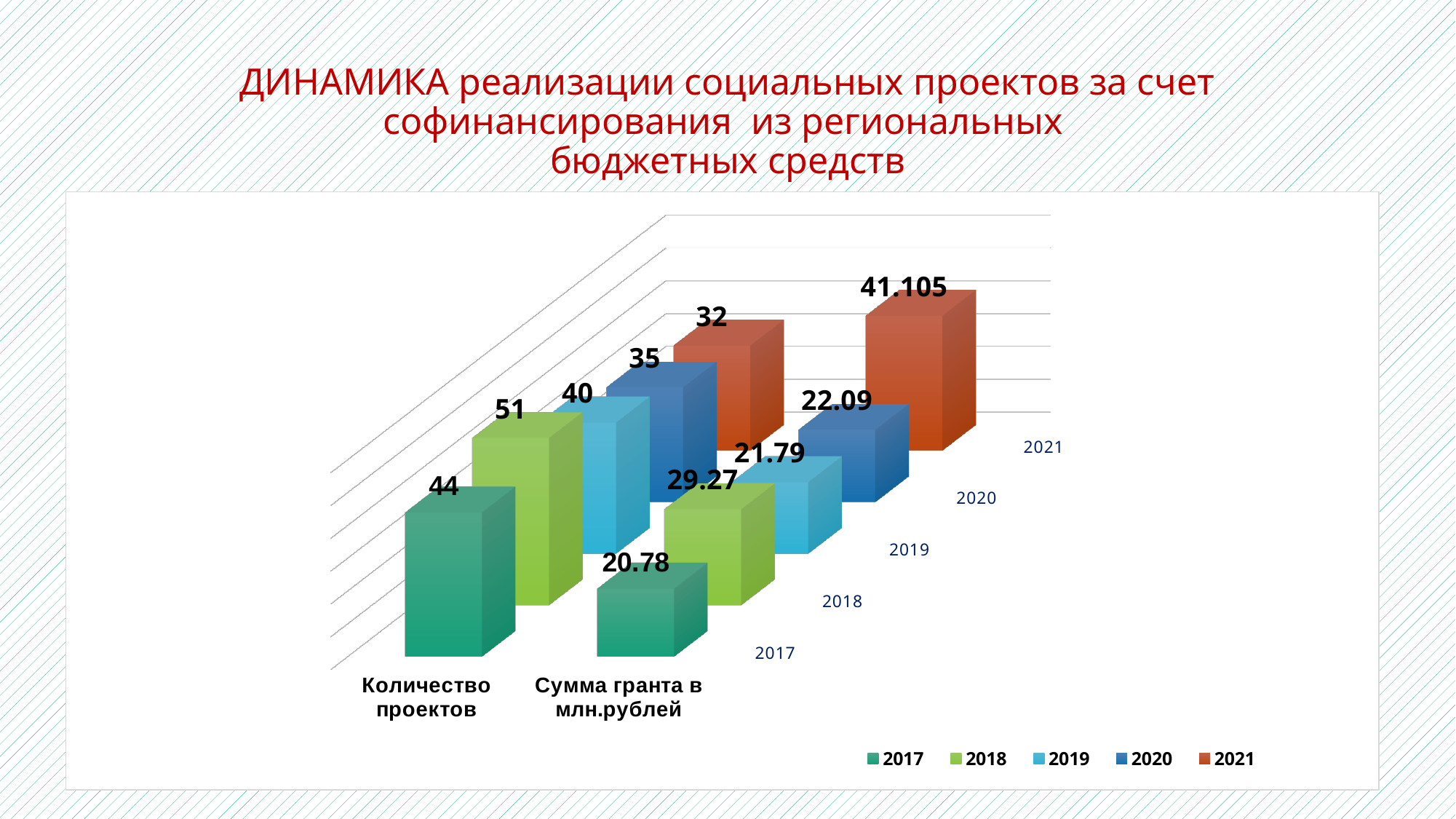
Which is larger: Сумма гранта в млн.рублей in 2018 or in 2020? 2018 What type of chart is shown on the slide? bar chart Which series is shown in red-orange in the legend? 2021 How many series does the legend list? 5 Which year has the highest value for Количество проектов? 2018 What is the value for Сумма гранта в млн.рублей in 2017? 20.78 What is the value for Количество проектов in 2018? 51 What is the value for Количество проектов in 2021? 32 What is the value for Сумма гранта в млн.рублей in 2021? 41.105 Which year has the lowest value for Сумма гранта в млн.рублей? 2017 What is the difference between the Количество проектов values for 2017 and 2021? 12 How many categories are shown on the x axis? 2